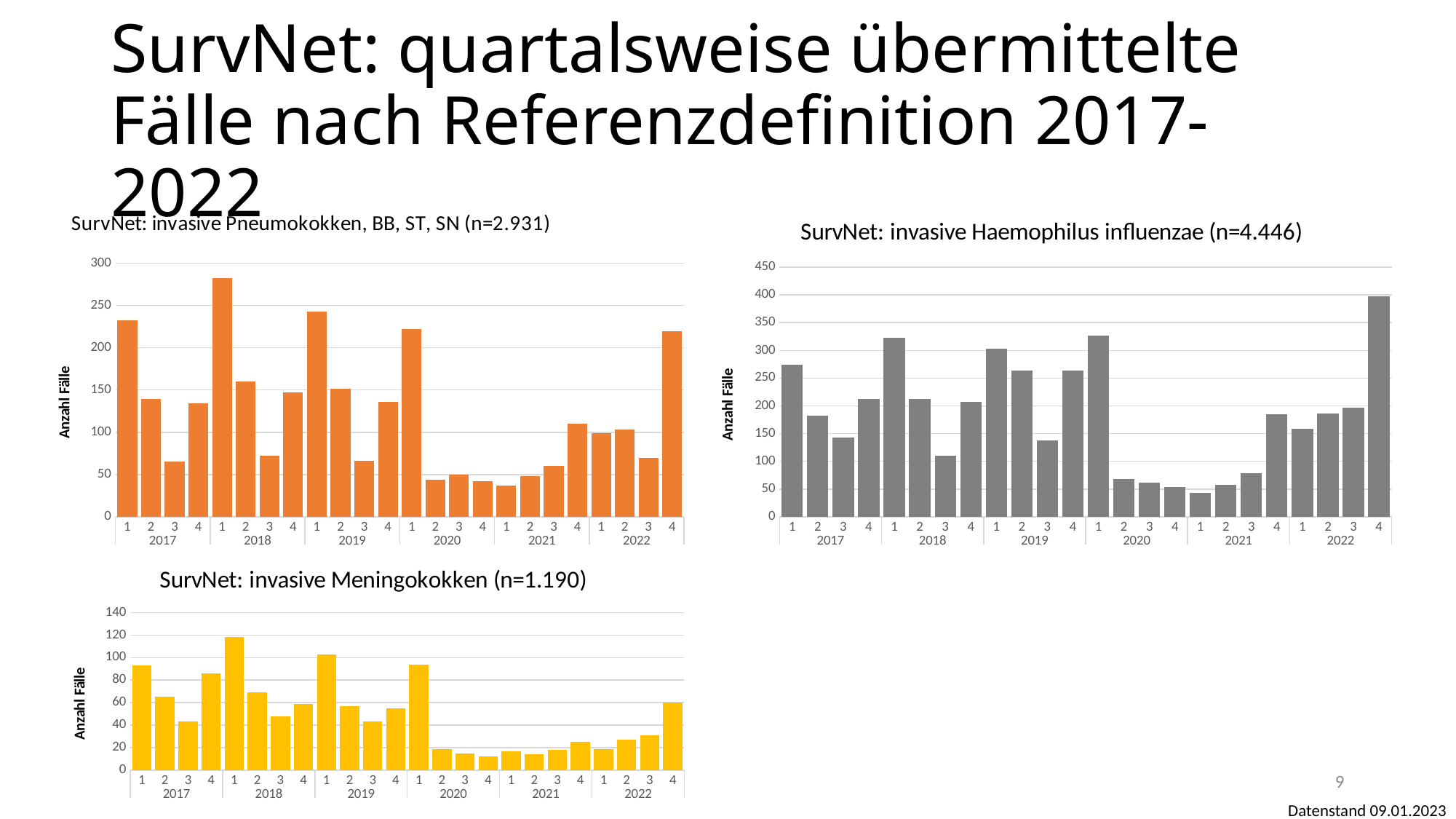
What kind of chart is the 'SurvNet: invasive Pneumokokken, BB, ST, SN (n=2.931)' chart? bar chart In the 'SurvNet: invasive Haemophilus influenzae (n=4.446)' chart, is the value for quarter 1 of 2020 greater or less than 300? greater In the 'SurvNet: invasive Meningokokken (n=1.190)' chart, is the value for quarter 1 of 2017 greater or less than 80? greater In the 'SurvNet: invasive Haemophilus influenzae (n=4.446)' chart, which quarter has the lowest value? Quarter 1 of 2021 In the 'SurvNet: invasive Pneumokokken, BB, ST, SN (n=2.931)' chart, is the value for quarter 2 of 2020 greater or less than 50? less In the 'SurvNet: invasive Meningokokken (n=1.190)' chart, which quarter has the highest value? Quarter 1 of 2018 In the 'SurvNet: invasive Pneumokokken, BB, ST, SN (n=2.931)' chart, which is larger: quarter 1 of 2018 or quarter 1 of 2019? Quarter 1 of 2018 In the 'SurvNet: invasive Pneumokokken, BB, ST, SN (n=2.931)' chart, which quarter has the highest value? Quarter 1 of 2018 In the 'SurvNet: invasive Haemophilus influenzae (n=4.446)' chart, which quarter has the highest value? Quarter 4 of 2022 What is the y-axis label on the 'SurvNet: invasive Meningokokken (n=1.190)' chart? Anzahl Fälle How many quarterly bars are plotted in the 'SurvNet: invasive Haemophilus influenzae (n=4.446)' chart? 24